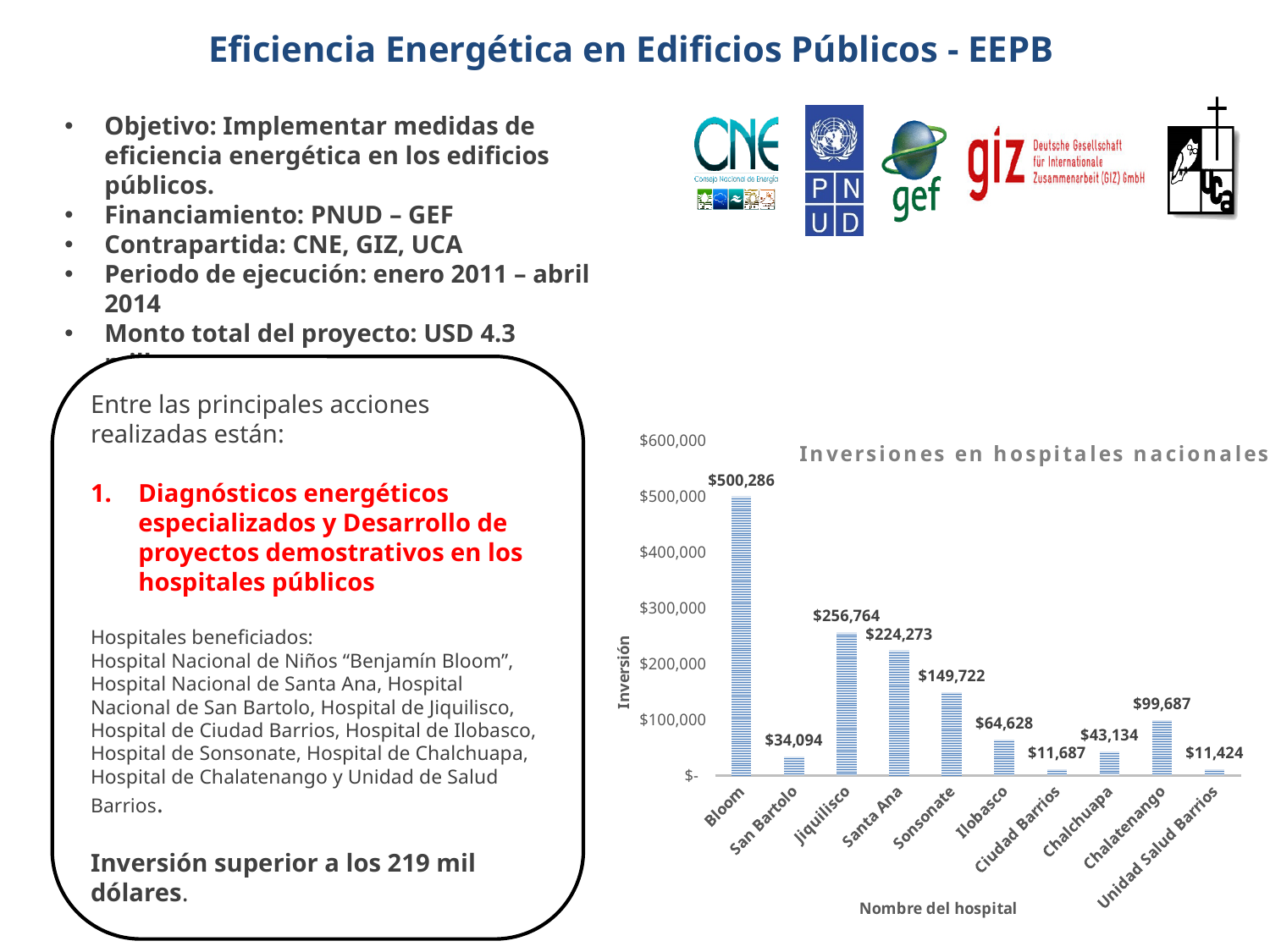
Which hospital has the lowest investment in the chart? Unidad Salud Barrios What is the investment value shown for Chalatenango? $99,687 What is the title of the chart on the slide? Inversiones en hospitales nacionales What is the label of the x axis of the chart? Nombre del hospital Is the value for Santa Ana greater or less than $200,000? greater What is the investment value shown for Sonsonate? $149,722 How many hospitals are shown on the x axis of the chart? 10 What is the difference between the investment for Jiquilisco and the investment for Santa Ana? $32,491 What kind of chart is used to show the investments in national hospitals? Bar chart Which has a larger investment, Ilobasco or Chalchuapa? Ilobasco Which hospital has the highest investment in the chart? Bloom What is the investment value shown for Bloom in the chart? $500,286